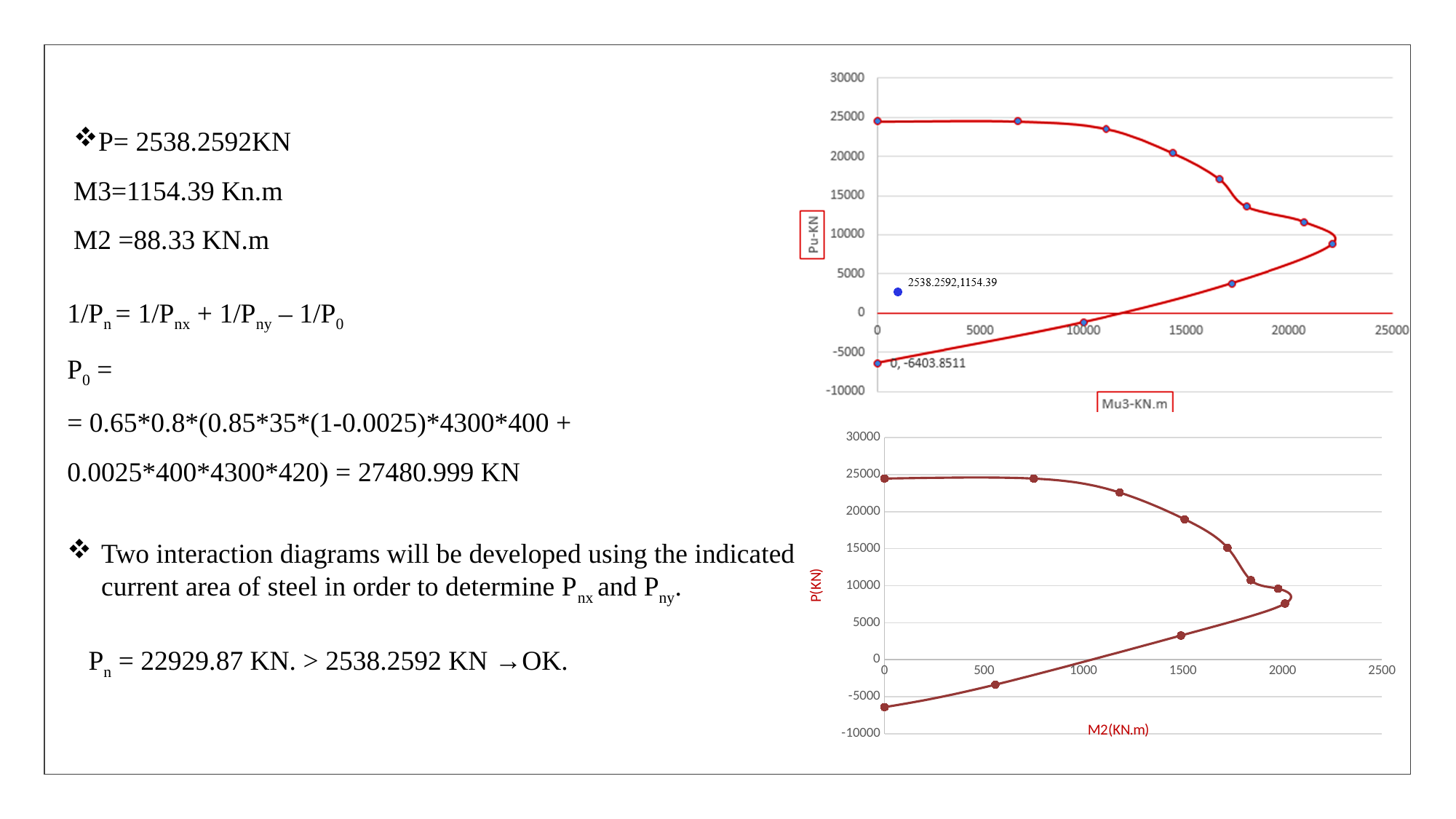
On the bottom chart (P(KN) vs M2(KN.m)), is the lowest P(KN) value on the curve greater or less than -5000? less On the top chart, is the largest Mu3-KN.m value reached by the curve greater or less than 20000? greater What is the label of the horizontal axis on the bottom chart? M2(KN.m) What is the label of the vertical axis on the top chart? Pu-KN On the bottom chart, is the largest M2(KN.m) value reached by the curve greater or less than 1500? greater What kind of chart is the top chart (Pu-KN vs Mu3-KN.m)? line chart On the top chart, what is the data label shown at the lowest point of the curve on the y axis? 0, -6403.8511 What is the maximum value shown on the vertical axis of the top chart? 30000 What is the maximum value shown on the horizontal axis of the bottom chart? 2500 On the top chart, what is the data label shown next to the isolated blue point? 2538.2592,1154.39